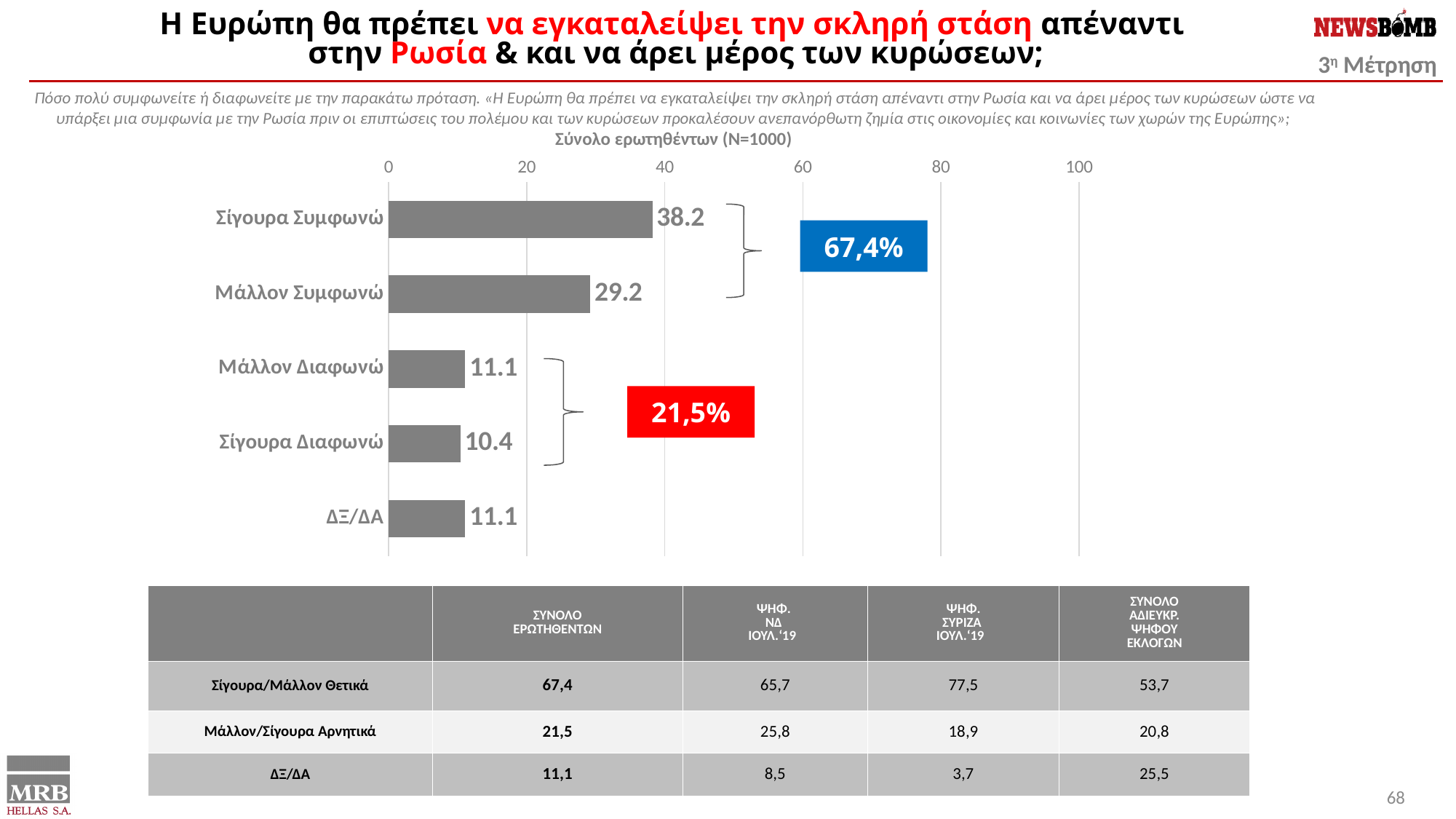
Which category has the lowest value? Σίγουρα Διαφωνώ How many categories does the bar chart show? 5 Which category has the highest value? Σίγουρα Συμφωνώ What is the value for Μάλλον Συμφωνώ? 29.2 What combined percentage is shown in the blue box next to the two Συμφωνώ bars? 67,4% Which is larger, the value for Μάλλον Διαφωνώ or the value for Σίγουρα Διαφωνώ? Μάλλον Διαφωνώ What is the value for ΔΞ/ΔΑ? 11.1 Is the value for Μάλλον Συμφωνώ greater or less than 20? greater What is the value for Σίγουρα Διαφωνώ? 10.4 What kind of chart is shown on the slide? bar chart What is the value for Σίγουρα Συμφωνώ? 38.2 What is the difference between the values for Σίγουρα Συμφωνώ and Μάλλον Συμφωνώ? 9.0